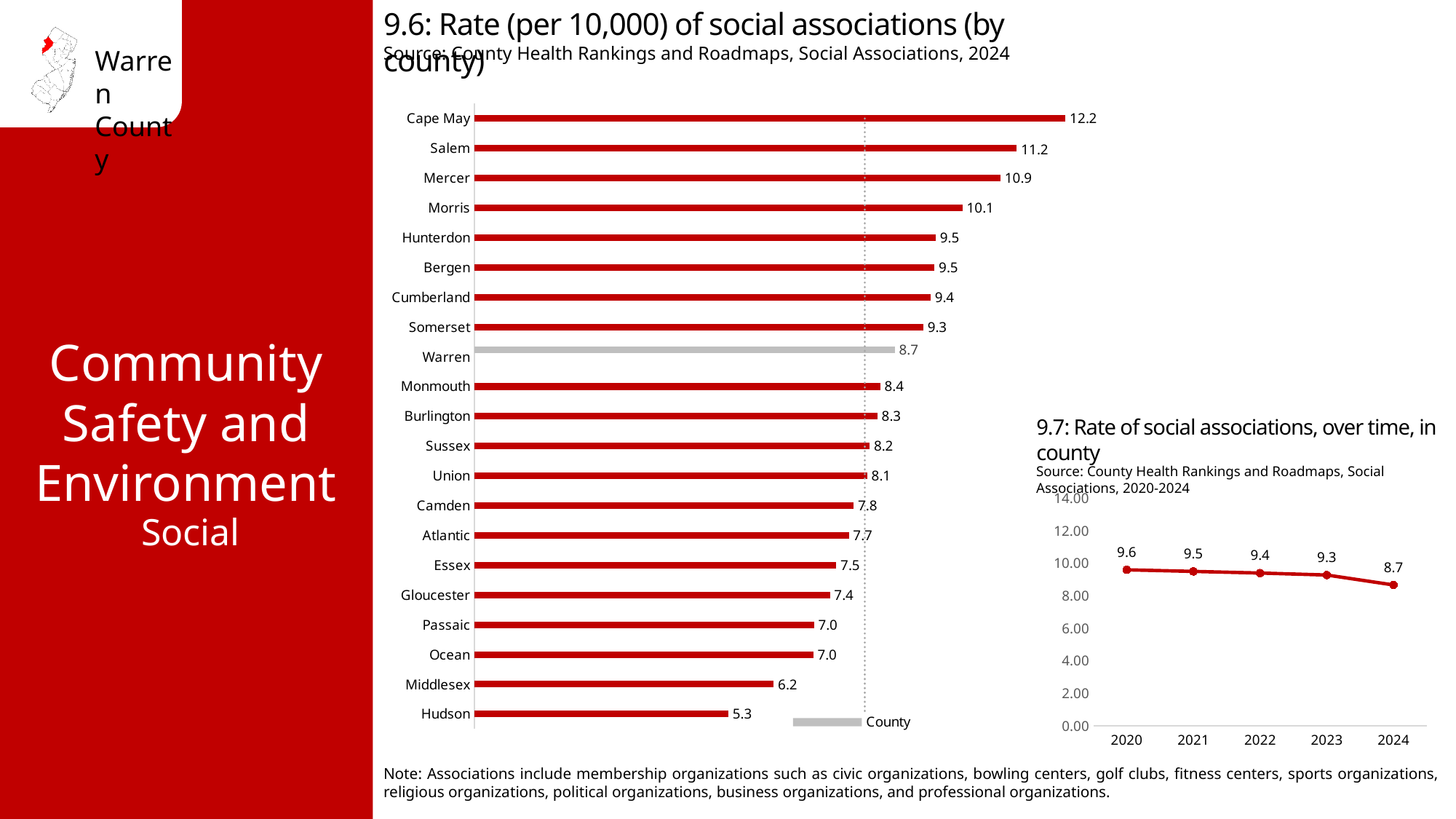
In chart 9.6 (rate of social associations by county), which county has the lowest rate? Hudson In chart 9.6 (rate of social associations by county), what is the value for Warren? 8.7 In chart 9.6 (rate of social associations by county), what is the difference between Cape May and Hudson? 6.9 In chart 9.7 (rate of social associations over time), do the values rise or fall from 2020 to 2024? Fall In chart 9.7 (rate of social associations over time), how many years are plotted? 5 What kind of chart is chart 9.6 (rate of social associations by county)? Bar chart In chart 9.6 (rate of social associations by county), which county has the highest rate? Cape May In chart 9.7 (rate of social associations over time), what is the difference between the 2020 and 2024 values? 0.9 In chart 9.6 (rate of social associations by county), what is the value for Middlesex? 6.2 In chart 9.6 (rate of social associations by county), which has a higher rate, Mercer or Morris? Mercer In chart 9.7 (rate of social associations over time), what is the value for 2024? 8.7 In chart 9.6 (rate of social associations by county), how many counties are shown? 21